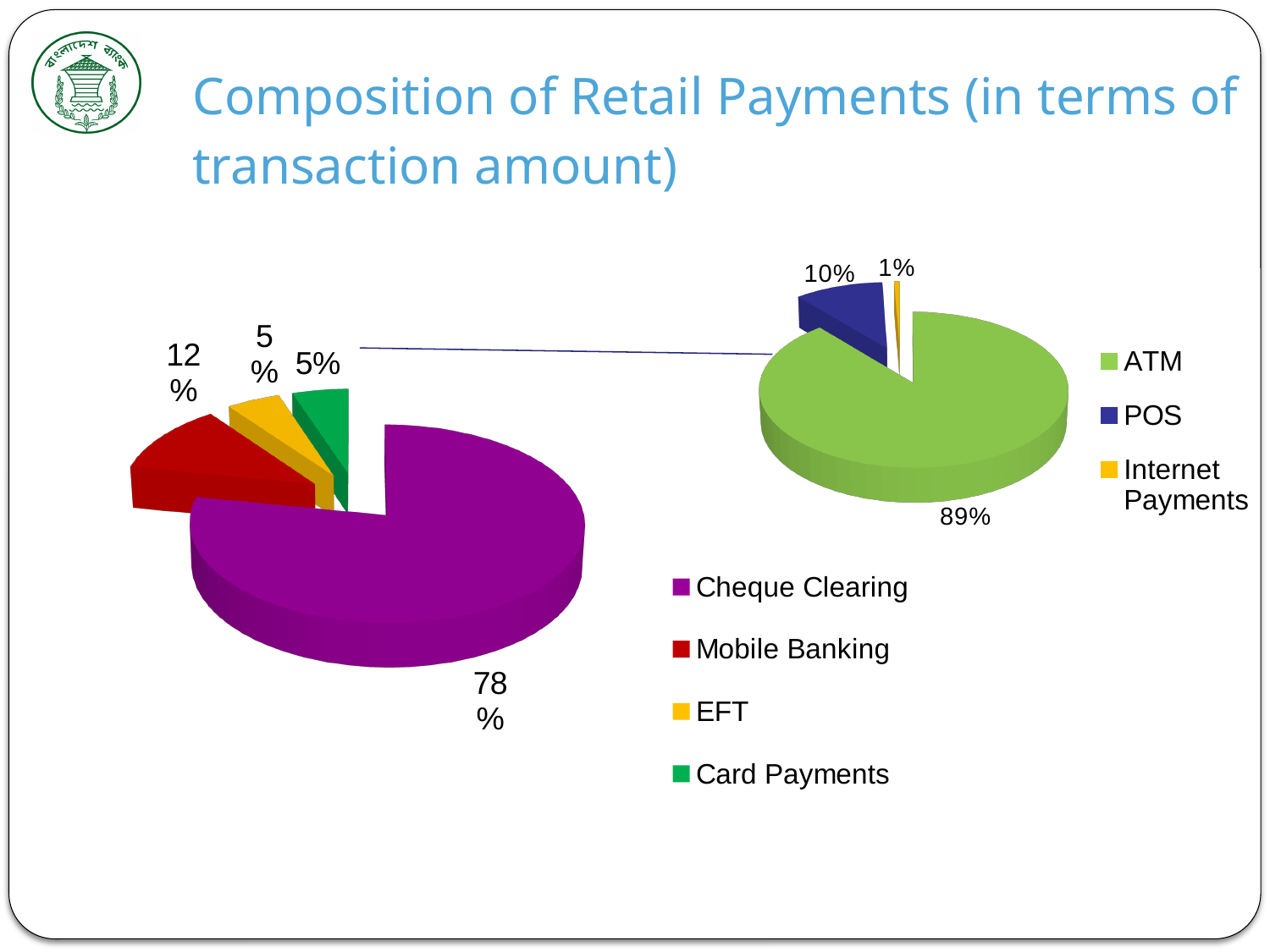
In the left pie chart, what is the difference between the Cheque Clearing share and the Mobile Banking share? 66 percentage points In the left pie chart, which category has the largest share? Cheque Clearing What type of chart is used on this slide? Pie chart In the right pie chart, what share is ATM? 89% In the right pie chart, what share is POS? 10% In the left pie chart, what share of retail payments is EFT? 5% In the right pie chart, which is larger, the POS share or the Internet Payments share? POS In the left pie chart, what share of retail payments is Mobile Banking? 12% In the right pie chart, which category has the smallest share? Internet Payments How many categories does the legend of the left pie chart list? 4 In the left pie chart, what share of retail payments is Cheque Clearing? 78% In the right pie chart, what share is Internet Payments? 1%